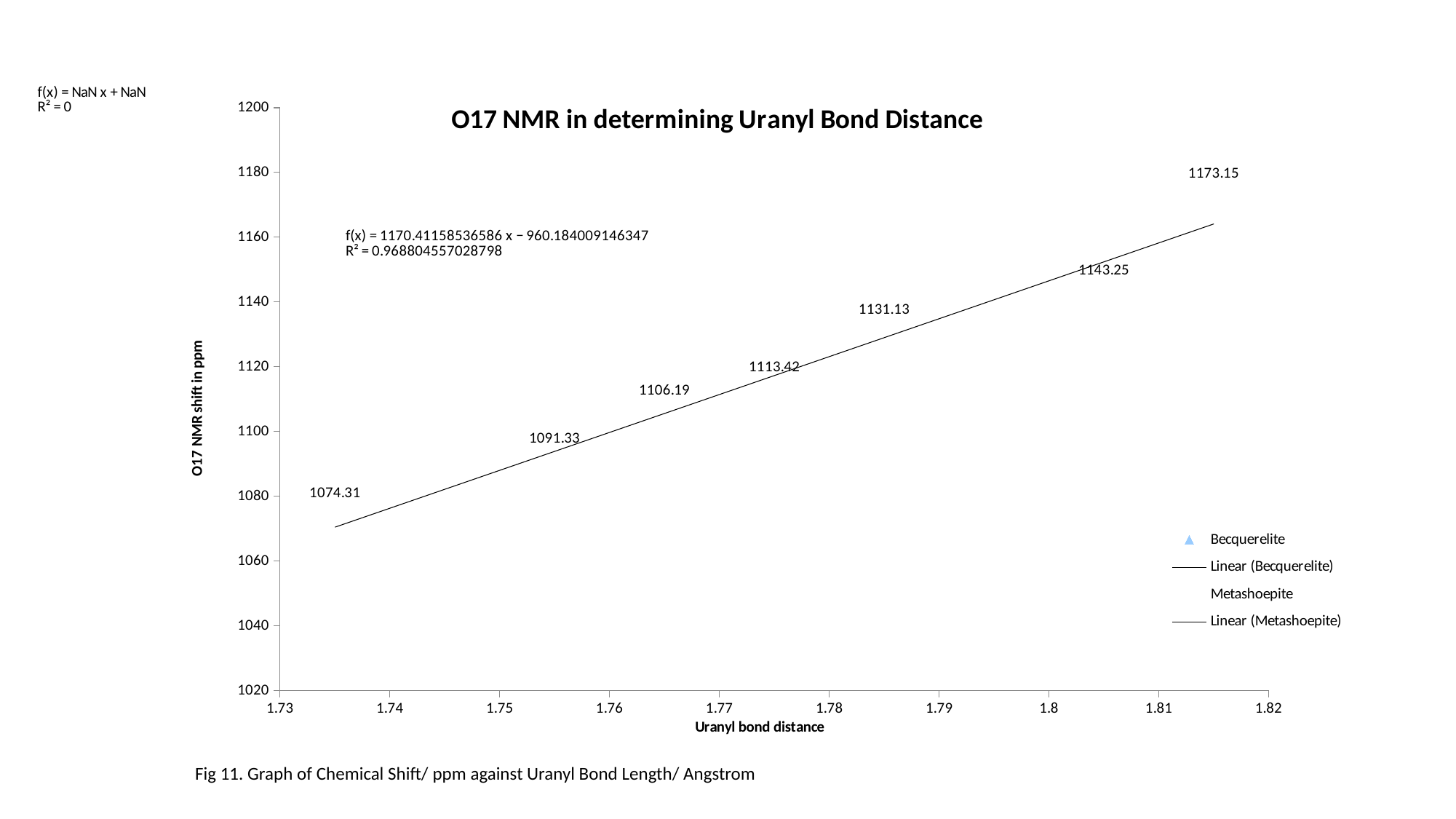
Which is larger, the point labelled 1106.19 or the point labelled 1113.42? 1113.42 What is the label of the leftmost data point on the chart? 1074.31 What is the difference between the points labelled 1143.25 and 1131.13? 12.12 What is the R² value shown for the trendline inside the plot area? R² = 0.968804557028798 How many entries does the chart legend list? 4 What is the highest labelled O17 NMR shift value on the chart? 1173.15 What kind of chart is shown on the slide? scatter chart with a linear trendline What is the title of the chart? O17 NMR in determining Uranyl Bond Distance What is the lowest labelled O17 NMR shift value on the chart? 1074.31 Do the O17 NMR shift values rise or fall as the uranyl bond distance increases? rise How many data points are labelled on the chart? 7 What is the difference between the highest and lowest labelled values on the chart? 98.84